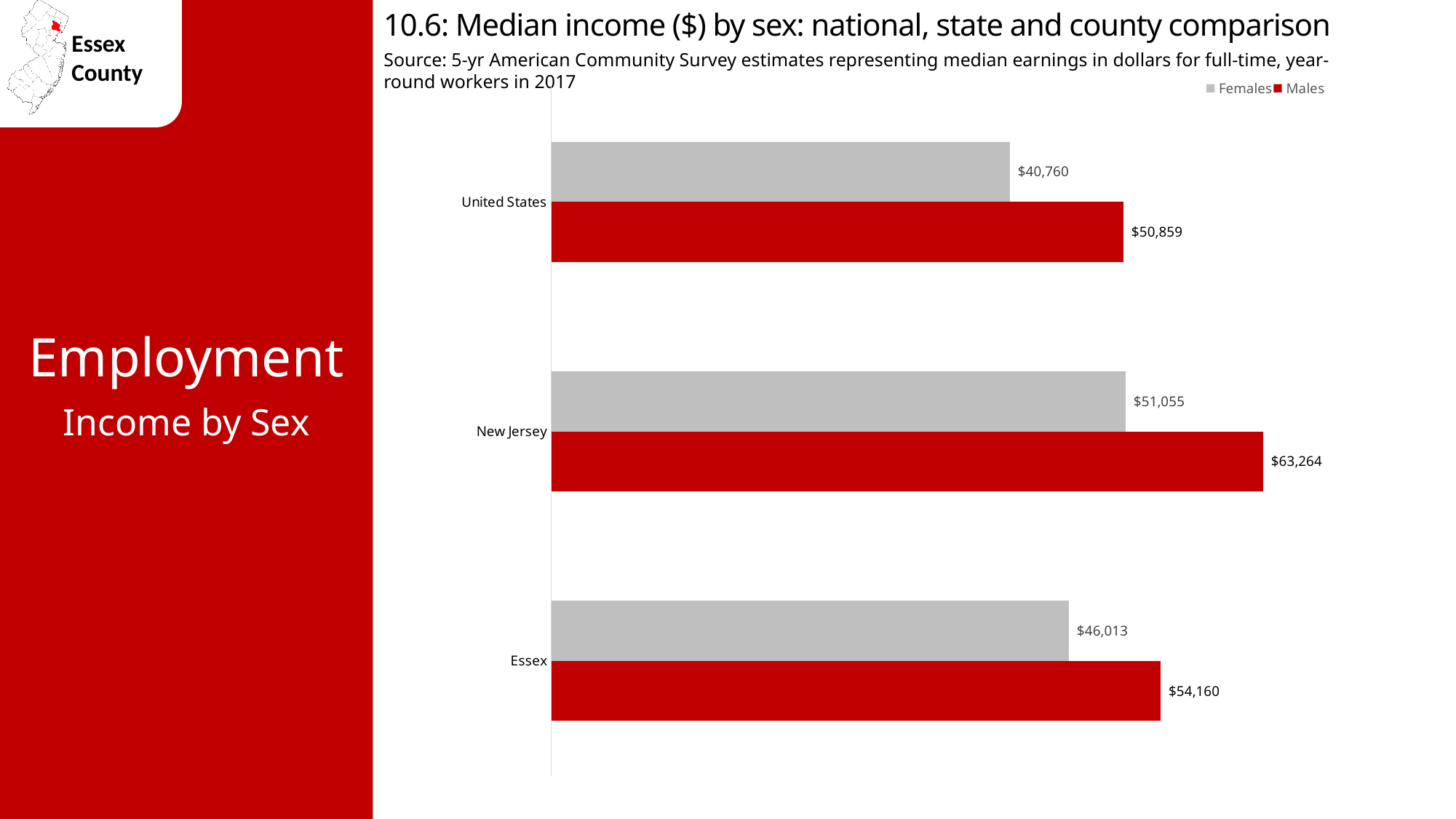
What kind of chart is shown on the slide? Bar chart What is the median income for males in New Jersey? $63,264 How many series does the legend list? 2 Which category has the highest median income for males? New Jersey What is the median income for females in Essex? $46,013 Which category has the lowest median income for females? United States What is the median income for males in Essex? $54,160 What is the median income for females in the United States? $40,760 What is the difference between male and female median income in Essex? $8,147 Which is larger: the female median income in New Jersey or the male median income in the United States? Female median income in New Jersey How many categories are shown on the chart? 3 What is the difference between male and female median income in New Jersey? $12,209